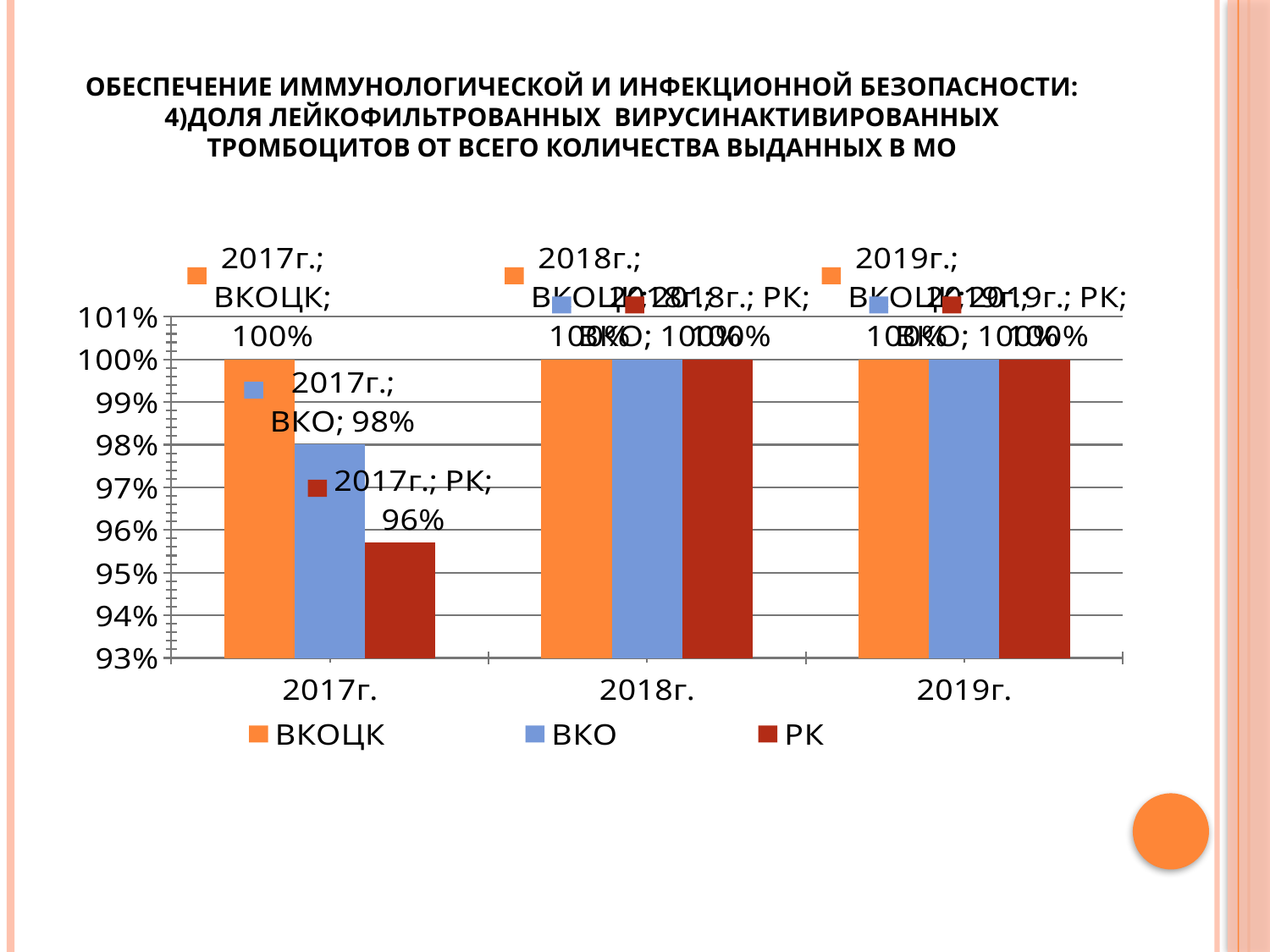
Which series has the lowest value in 2017г.? РК Which series has the highest value in 2017г.? ВКОЦК Which is larger in 2017г., the value for ВКО or the value for РК? ВКО What is the value for ВКО in 2018г.? 100% What is the value for ВКО in 2017г.? 98% What kind of chart is shown on the slide? bar chart What is the value for РК in 2017г.? 96% Does the value for РК rise or fall from 2017г. to 2018г.? rise How many series does the legend list? 3 What is the value for ВКОЦК in 2017г.? 100% What is the difference between the ВКОЦК and ВКО values in 2017г.? 2% How many year categories are shown on the x axis? 3